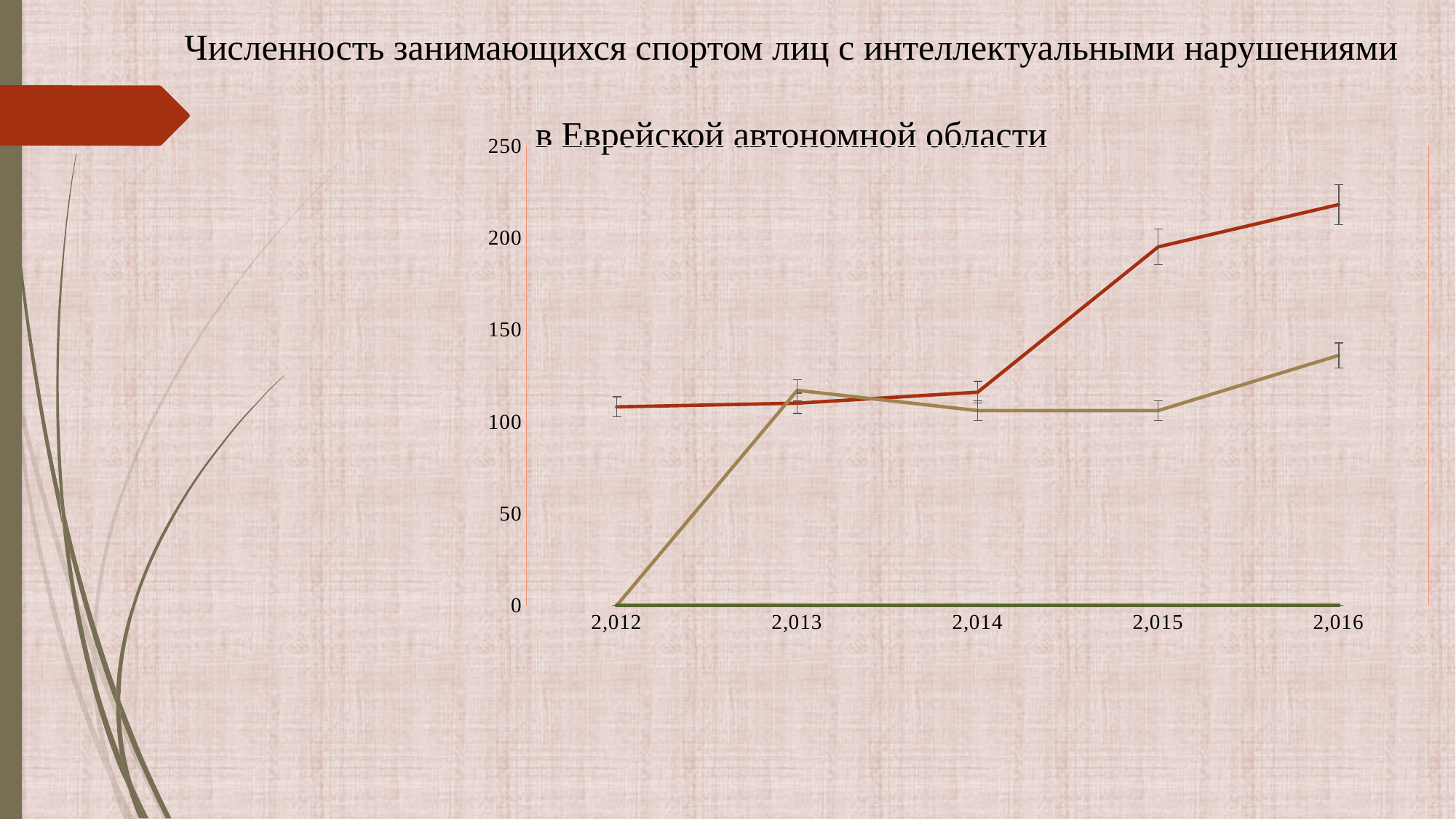
What kind of chart is shown on the slide? line chart How many lines are plotted on the chart? 3 Is the value of the red line for 2,015 greater or less than 150? greater In which year does the red line reach its highest value? 2,016 What is the title of the chart? Численность занимающихся спортом лиц с интеллектуальными нарушениями в Еврейской автономной области Which line is higher at 2,016, the red line or the tan line? the red line Is the value of the red line for 2,012 greater or less than 150? less How many years are shown along the x axis of the chart? 5 Is the value of the red line for 2,016 greater or less than 200? greater Does the red line generally rise or fall from 2,012 to 2,016? rise What is the value of the tan line for 2,012? 0